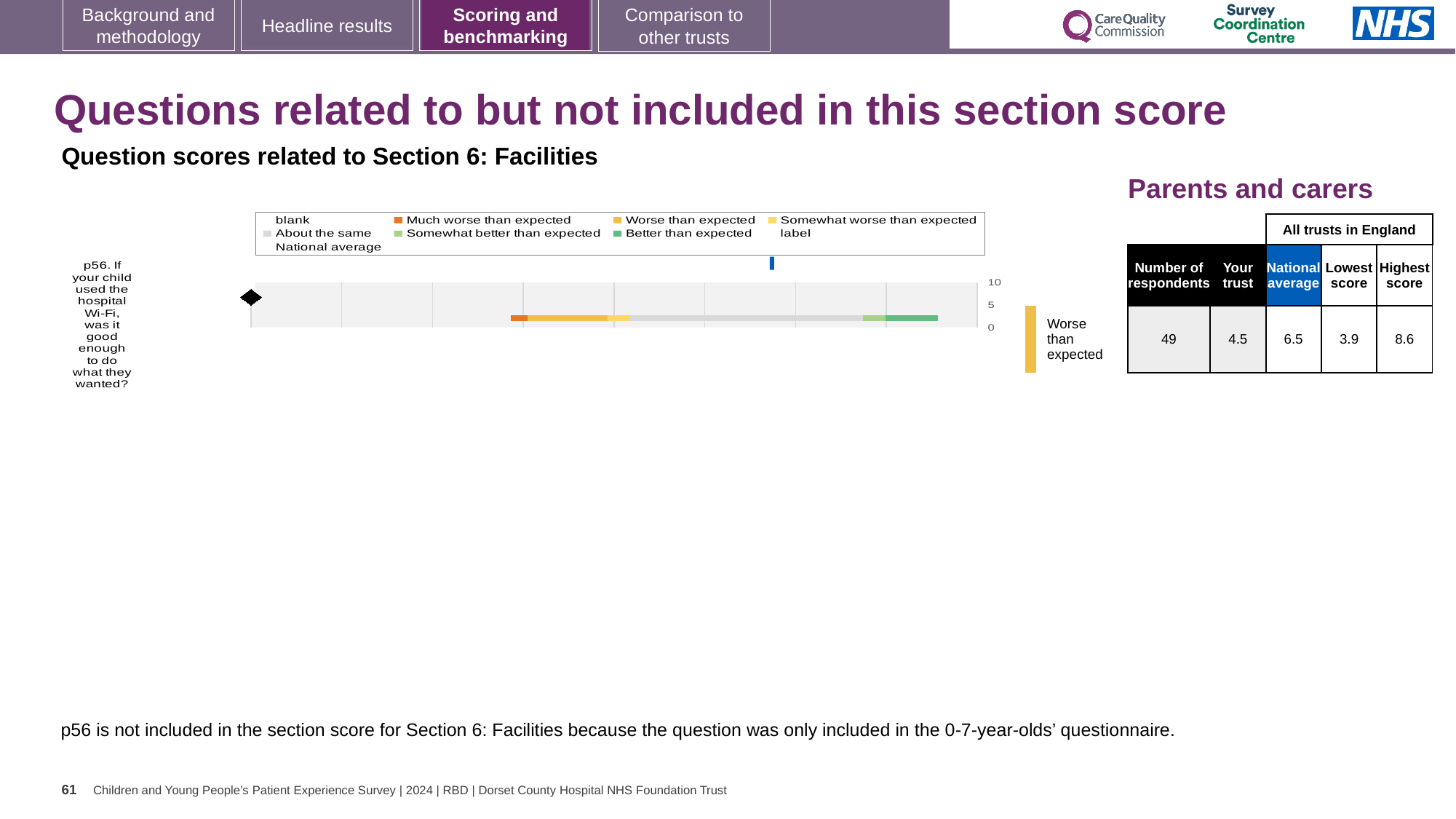
What rating label is shown to the right of the chart for question p56? Worse than expected What kind of chart is used to show the benchmarking result for question p56? bar chart For p56, what is the difference between the highest score and the lowest score among all trusts in England? 4.7 According to the table beside the chart, what is the national average score for p56? 6.5 According to the table beside the chart, what is the lowest score among all trusts in England for p56? 3.9 According to the table beside the chart, what is the highest score among all trusts in England for p56? 8.6 How many questions are plotted in the chart? 1 According to the table beside the chart, what is the 'Your trust' score for p56? 4.5 How many entries does the chart's legend list? 9 What colour does the legend use for 'Much worse than expected'? orange According to the table beside the chart, how many respondents answered p56? 49 For p56, which is larger: the 'Your trust' score or the national average? National average